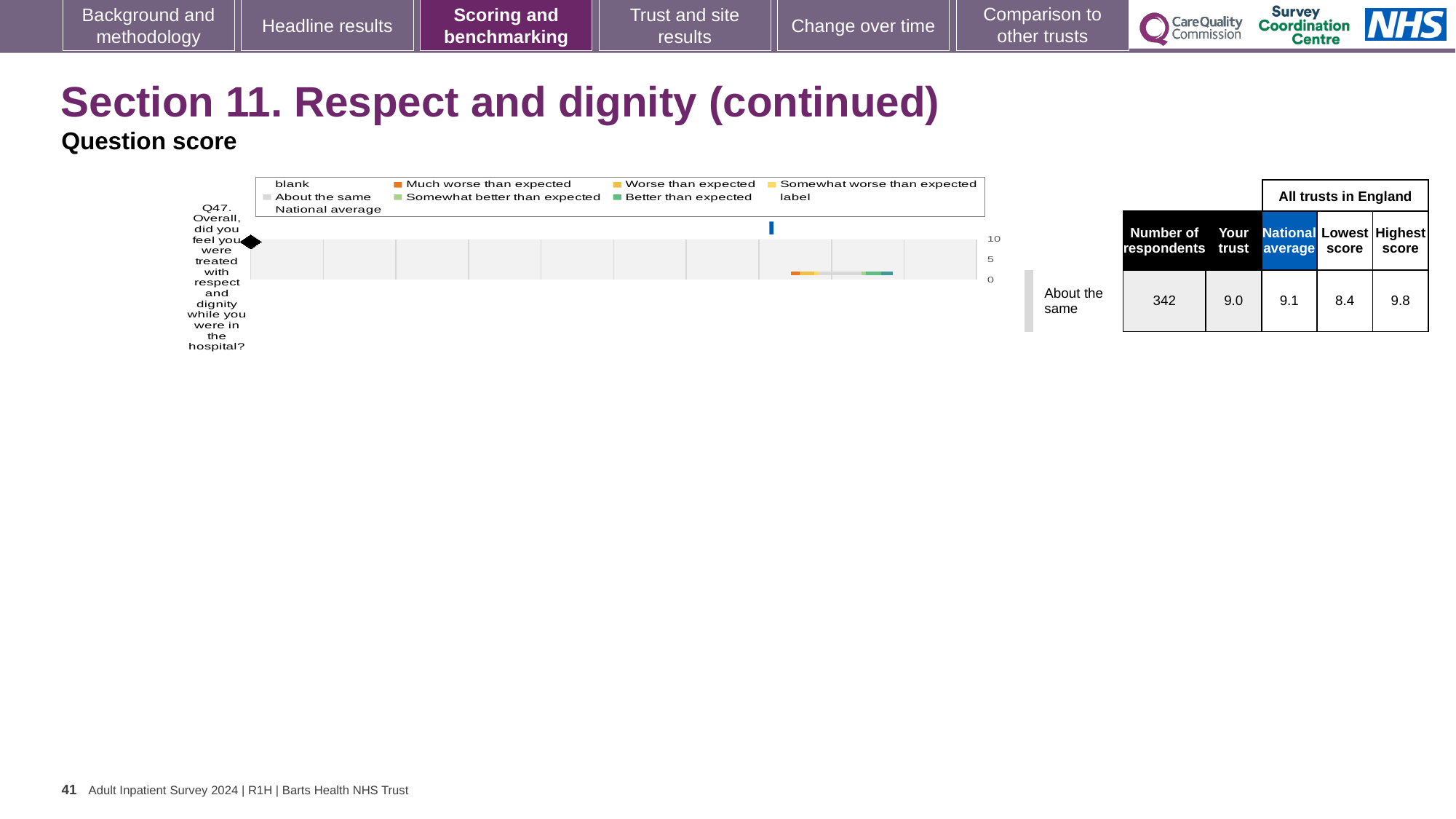
How many survey questions are plotted on the chart? 1 What kind of chart is shown on the slide for Q47? bar chart Is the 'Your trust' score for Q47 greater or less than 5 on the chart's axis? greater What is the highest value shown on the chart's score axis? 10 What is the difference between the highest and lowest scores among all trusts in England for Q47? 1.4 Which is larger for Q47, the 'Your trust' score or the national average? National average Which benchmarking category is Q47 assigned to on the slide? About the same According to the table beside the chart, what is the lowest score among all trusts in England for Q47? 8.4 According to the table beside the chart, what is the highest score among all trusts in England for Q47? 9.8 According to the table beside the chart, how many respondents answered Q47? 342 According to the table beside the chart, what is the 'Your trust' score for Q47? 9.0 According to the table beside the chart, what is the national average score for Q47? 9.1